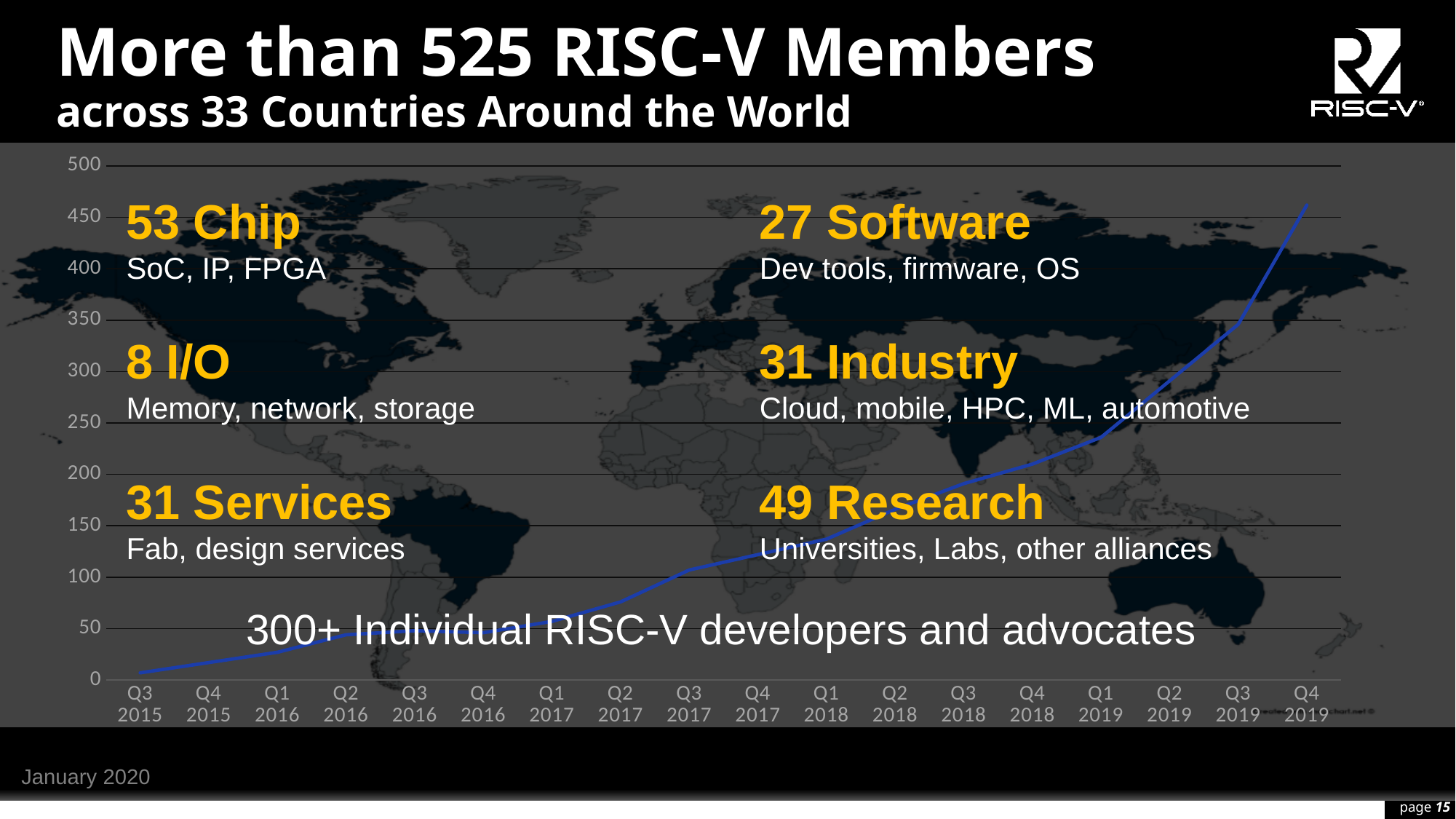
Is the value for Q3 2017 greater or less than 150? less What kind of chart is shown on the slide? line chart Is the value for Q4 2019 greater or less than 400? greater Is the value for Q3 2019 greater or less than 300? greater Which is larger, the value for Q3 2018 or the value for Q3 2019? Q3 2019 Which quarter has the lowest value in the chart? Q3 2015 How many quarters are plotted along the x axis of the chart? 18 Do the values in the chart rise or fall from Q3 2015 to Q4 2019? rise What is the highest tick value shown on the y axis of the chart? 500 Which quarter has the highest value in the chart? Q4 2019